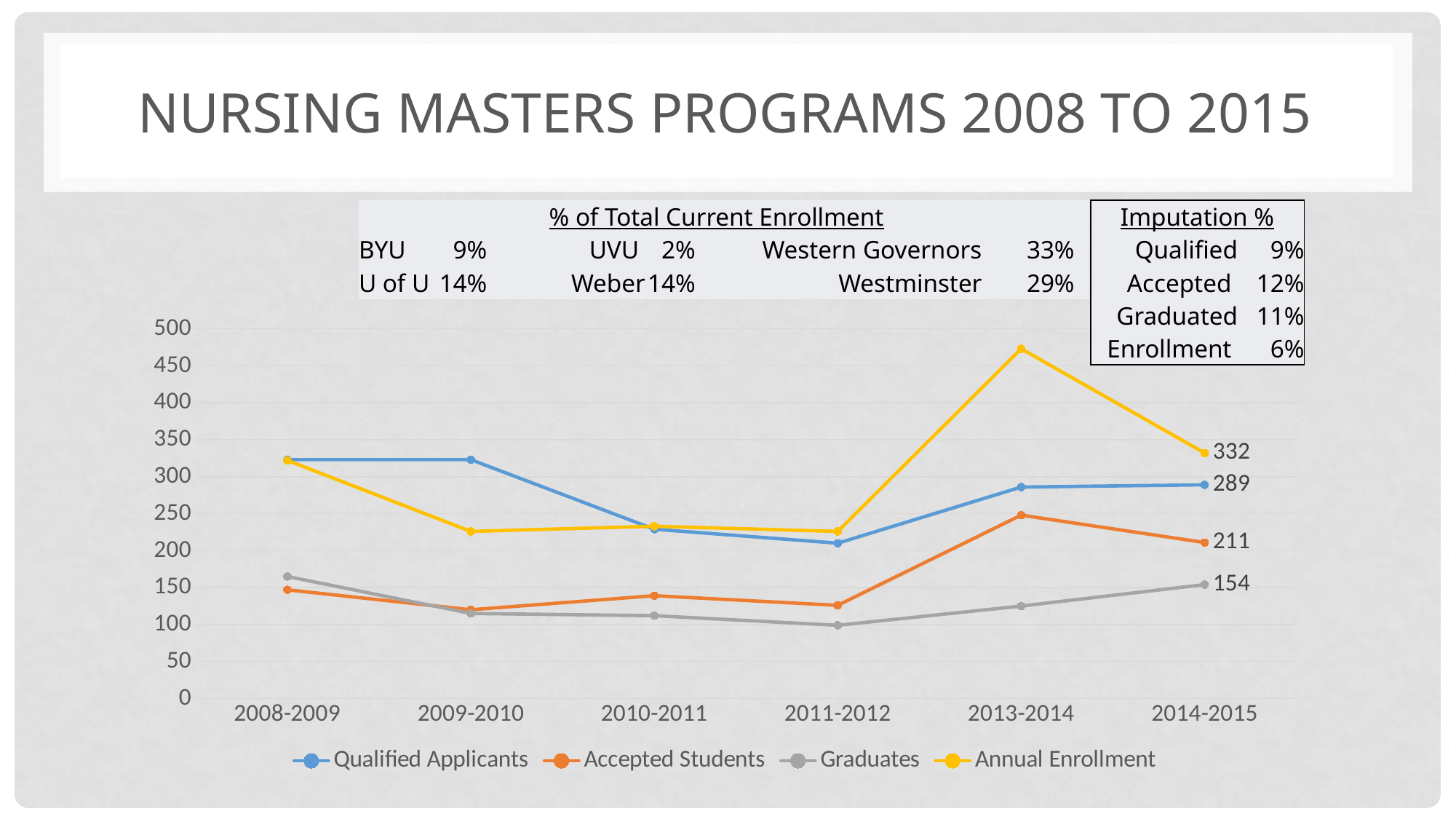
What is the Graduates value for 2014-2015? 154 Which series has the highest value in 2014-2015? Annual Enrollment How many academic-year categories are shown on the x axis? 6 Is the Annual Enrollment value for 2013-2014 greater or less than 450? greater What is the difference between Qualified Applicants and Accepted Students in 2014-2015? 78 What is the Accepted Students value for 2014-2015? 211 Which series has the lowest value in 2014-2015? Graduates What is the Annual Enrollment value for 2014-2015? 332 Does the Annual Enrollment line rise or fall from 2013-2014 to 2014-2015? fall How many series does the chart legend list? 4 What kind of chart is shown on the slide? line chart What is the Qualified Applicants value for 2014-2015? 289